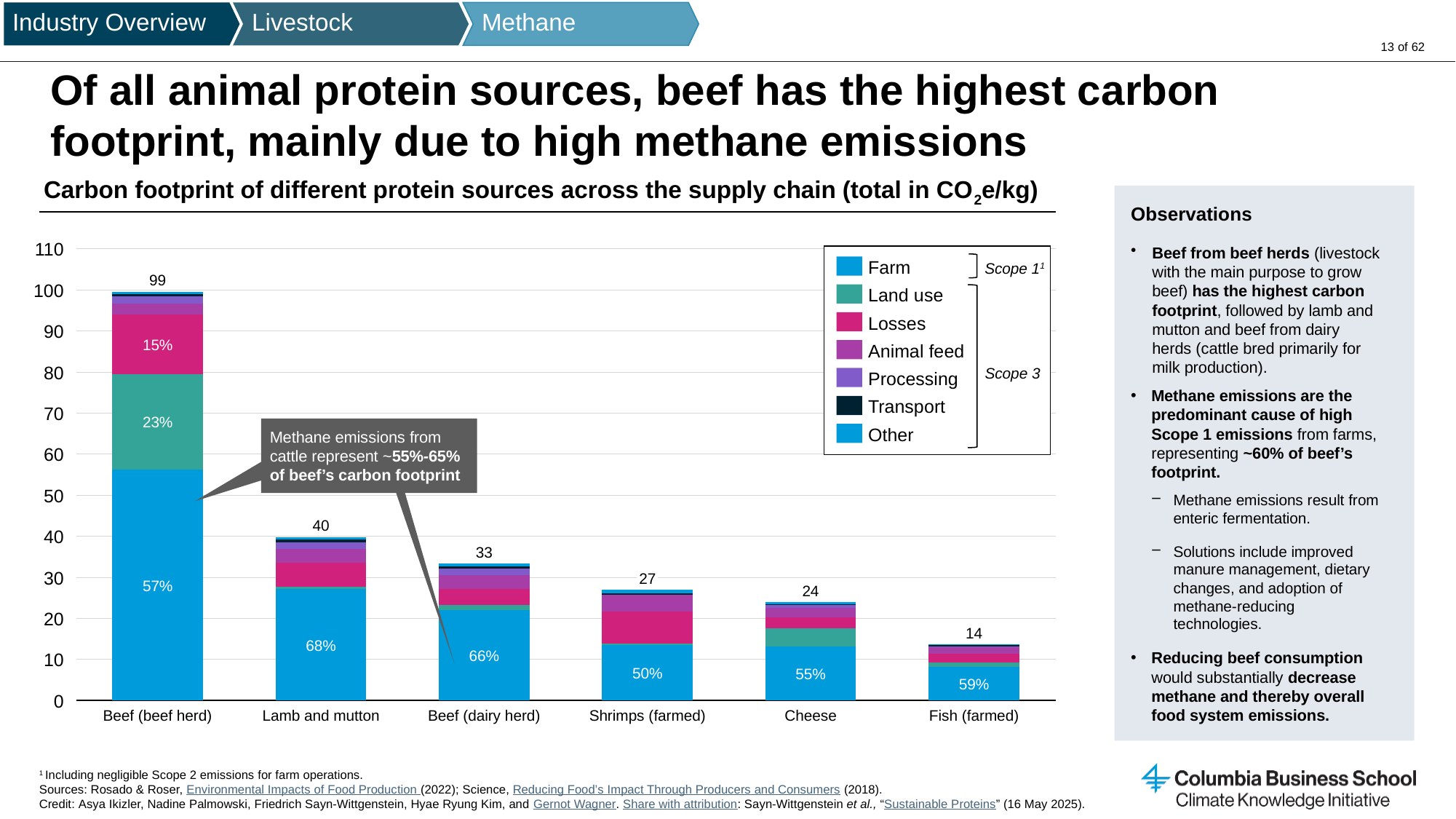
How many protein sources are shown on the x axis? 6 Which protein source has the highest total carbon footprint? Beef (beef herd) What is the total carbon footprint shown for Lamb and mutton? 40 What percentage of the Beef (beef herd) bar is attributed to Land use? 23% What kind of chart is shown on the slide? Stacked bar chart Which has a larger total carbon footprint, Shrimps (farmed) or Cheese? Shrimps (farmed) What percentage of the Beef (dairy herd) bar is attributed to Farm? 66% How many series does the legend list? 7 Which legend entry is labelled as Scope 1? Farm What is the difference between the total for Beef (beef herd) and the total for Lamb and mutton? 59 Which protein source has the lowest total carbon footprint? Fish (farmed) What is the total carbon footprint shown for Beef (beef herd)? 99